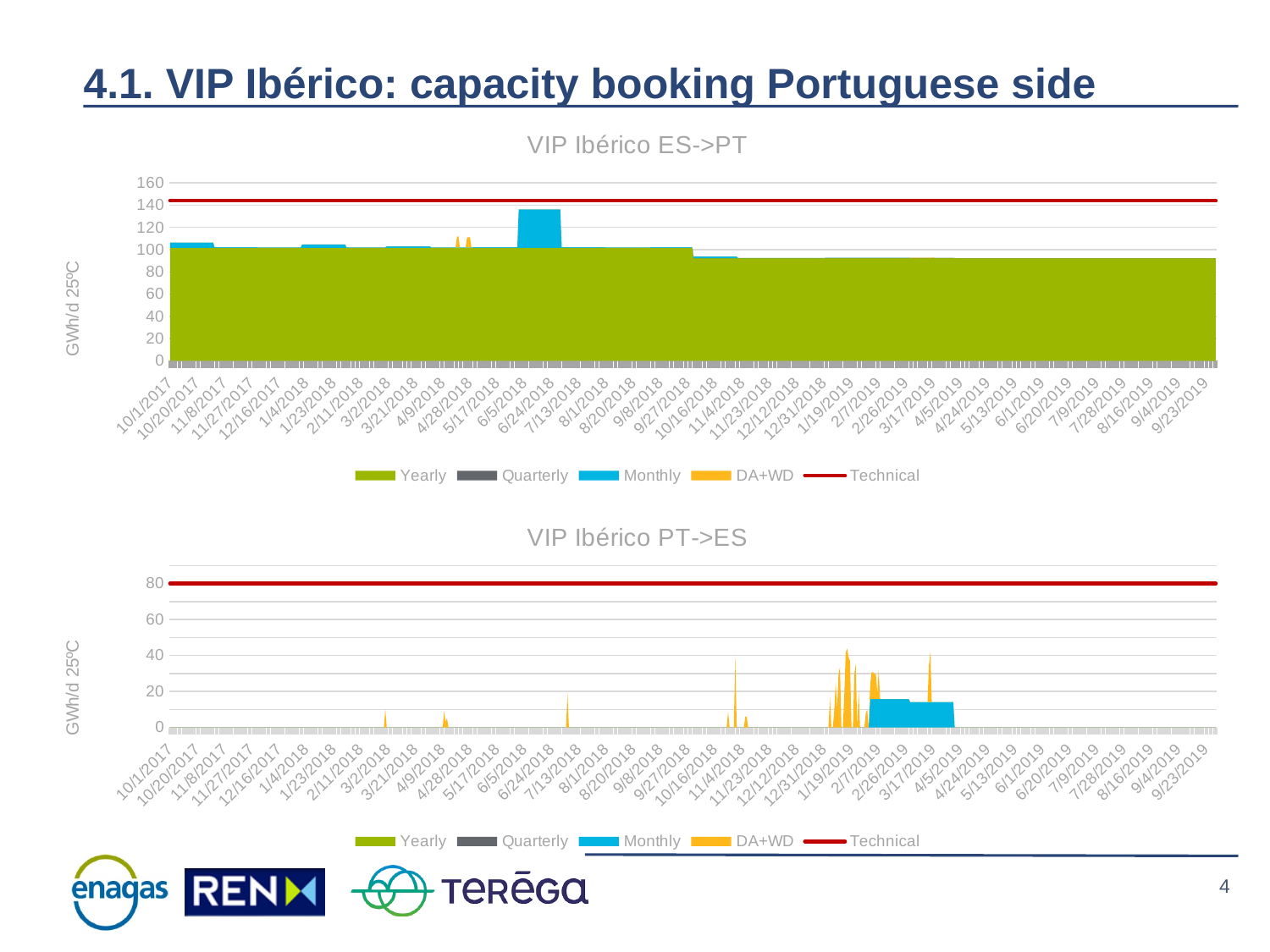
What is the title of the top chart on the slide? VIP Ibérico ES->PT In the 'VIP Ibérico ES->PT' chart, does the Yearly series rise or fall from October 2017 to September 2019? fall In the 'VIP Ibérico PT->ES' chart, is the highest DA+WD spike around January 2019 greater or less than 20? greater In the 'VIP Ibérico PT->ES' chart, what value does the Technical line sit at? 80 Which chart has the higher Technical line, 'VIP Ibérico ES->PT' or 'VIP Ibérico PT->ES'? VIP Ibérico ES->PT What kind of chart is 'VIP Ibérico PT->ES'? area chart In the 'VIP Ibérico ES->PT' chart, is the Technical line greater or less than 120? greater In the 'VIP Ibérico PT->ES' chart, is the Monthly value around 2/26/2019 greater or less than 40? less What is the y-axis label of the 'VIP Ibérico PT->ES' chart? GWh/d 25ºC How many series does the legend of the 'VIP Ibérico ES->PT' chart list? 5